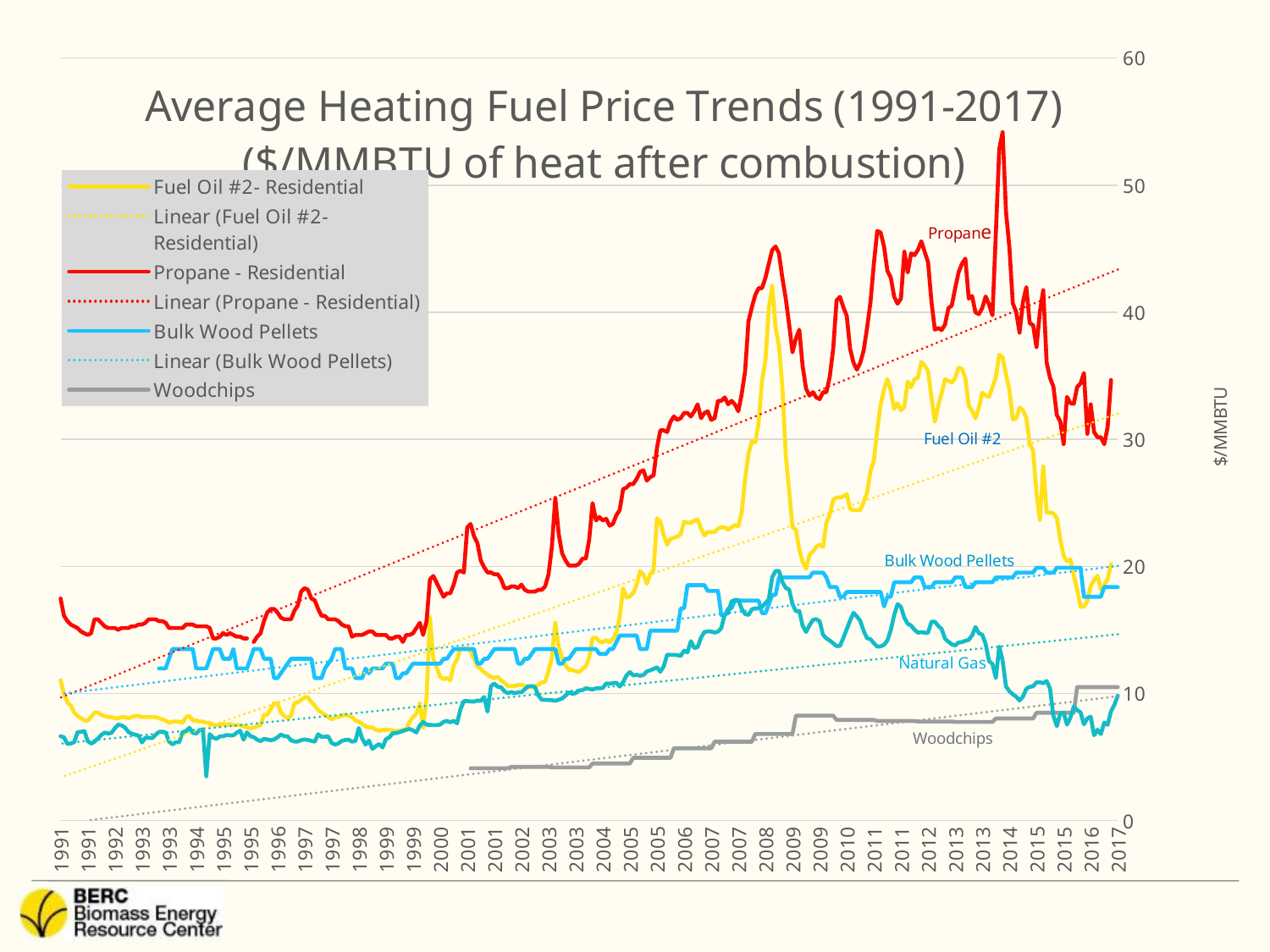
Is the peak value of the Fuel Oil #2 series around 2008 greater or less than 40? greater Is the peak value of the Propane series around 2014 greater or less than 50? greater What is the title of the chart? Average Heating Fuel Price Trends (1991-2017) ($/MMBTU of heat after combustion) What is the label on the vertical axis of the chart? $/MMBTU Is the value of the Woodchips series in 2001 greater or less than 10? less In 2015, which is higher: Bulk Wood Pellets or Woodchips? Bulk Wood Pellets Which fuel series has the lowest values on the chart? Woodchips What kind of chart is shown on the slide? Line chart Which fuel series reaches the highest value on the chart? Propane How many entries does the chart legend list? 7 Does the Propane series generally rise or fall from 1991 to 2017? Rise